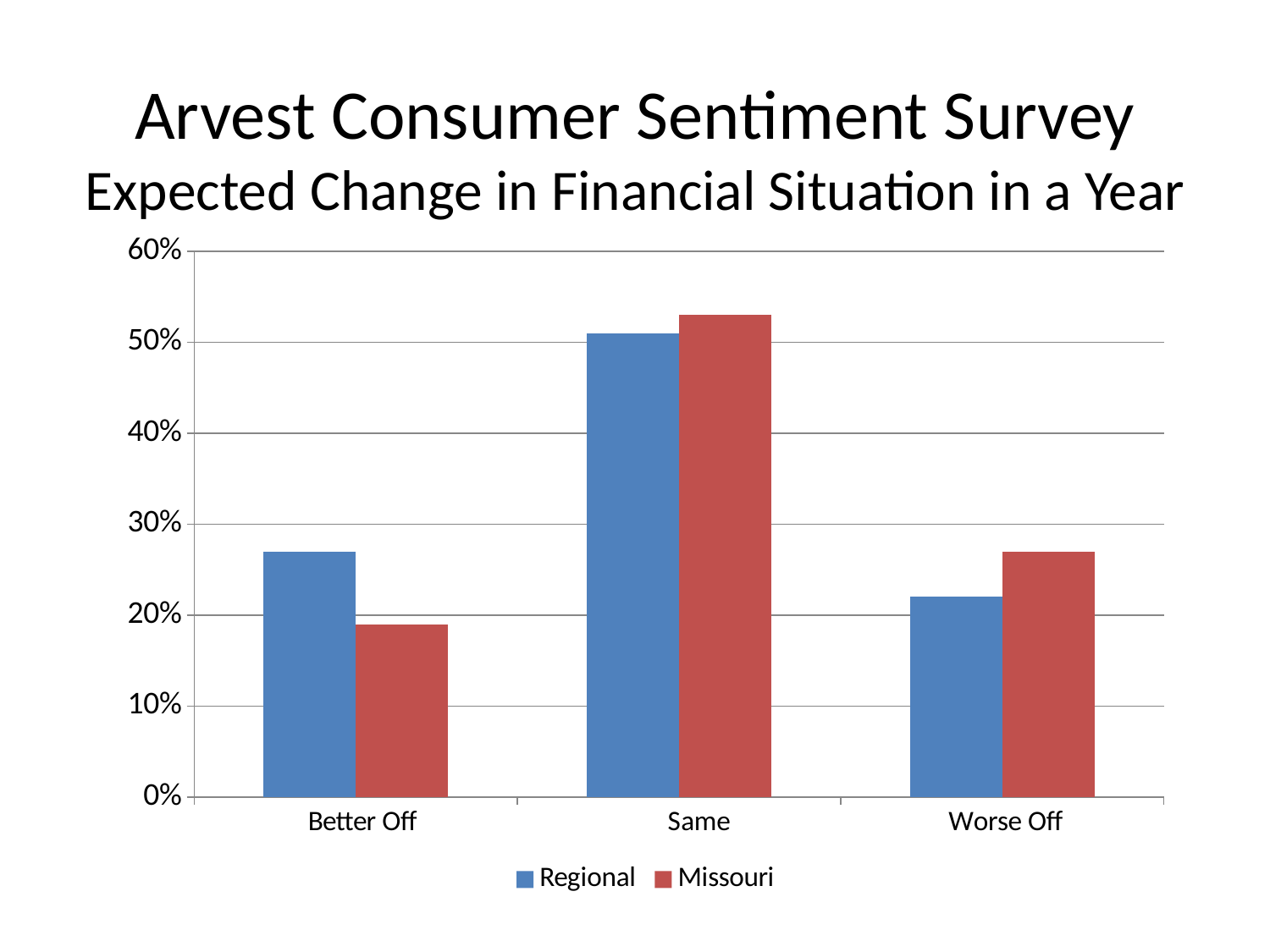
How many series does the legend list? 2 Is the Missouri value for Same greater or less than 40%? greater Is the Regional value for Better Off greater or less than 20%? greater Which category has the lowest value for the Regional series? Worse Off What colour are the bars for the Missouri series? red Which category has the highest value for the Regional series? Same Is the Missouri value for Worse Off greater or less than 30%? less For Worse Off, which series has the larger value, Regional or Missouri? Missouri For Better Off, which series has the larger value, Regional or Missouri? Regional How many categories are shown on the x axis? 3 What kind of chart is shown on the slide? bar chart Which category has the lowest value for the Missouri series? Better Off